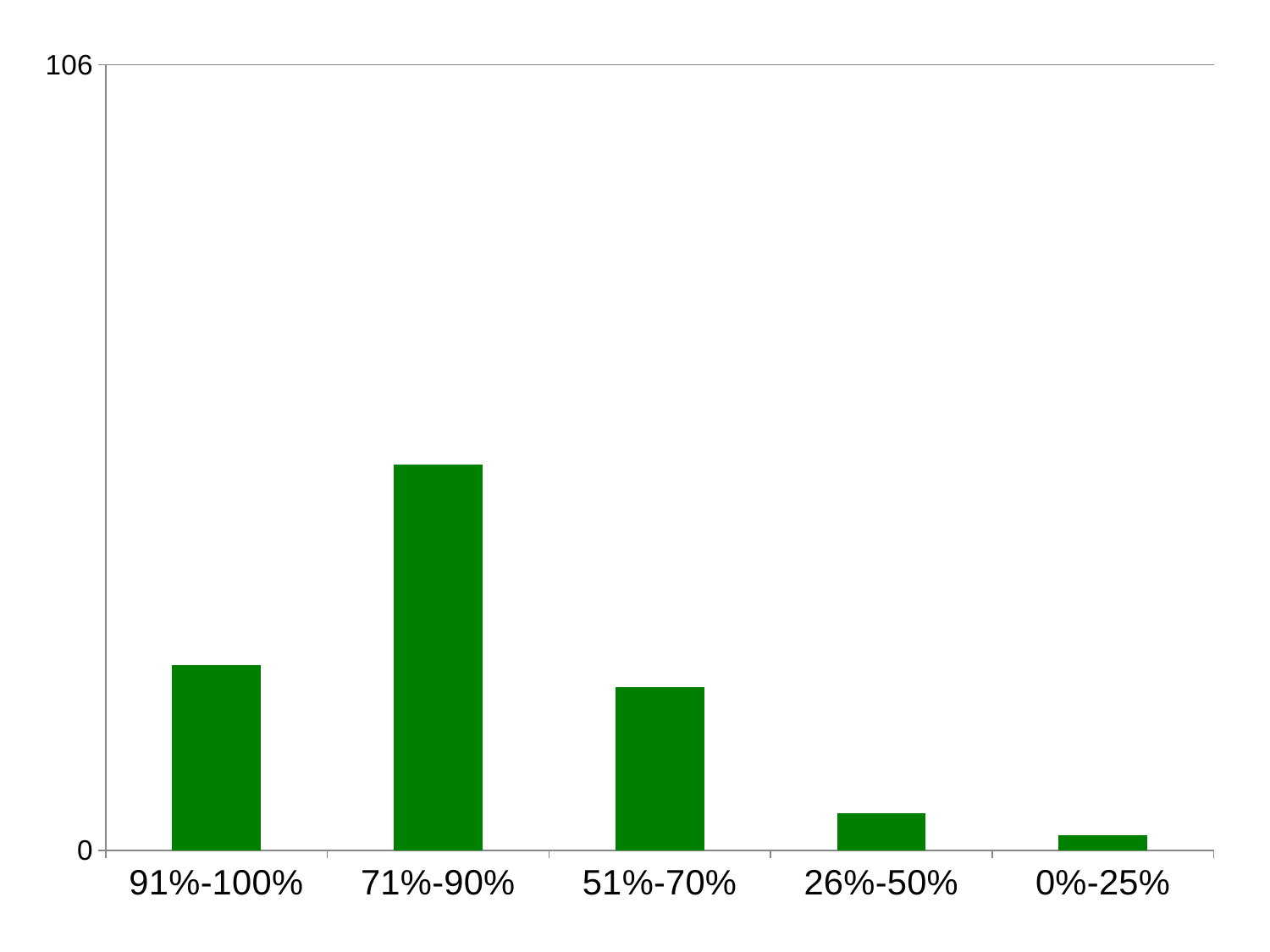
Which category has the highest bar? 71%-90% Which is larger, the value for 91%-100% or the value for 0%-25%? 91%-100% Which is larger, the value for 71%-90% or the value for 51%-70%? 71%-90% How many categories are shown on the x axis of the chart? 5 What colour are the bars in the chart? green What kind of chart is shown on the slide? bar chart Which category has the lowest bar? 0%-25% Do the values consistently decrease from left to right across the x axis? no Which is larger, the value for 71%-90% or the value for 91%-100%? 71%-90% What is the highest value labelled on the y axis? 106 Which category is shown first (leftmost) on the x axis? 91%-100%